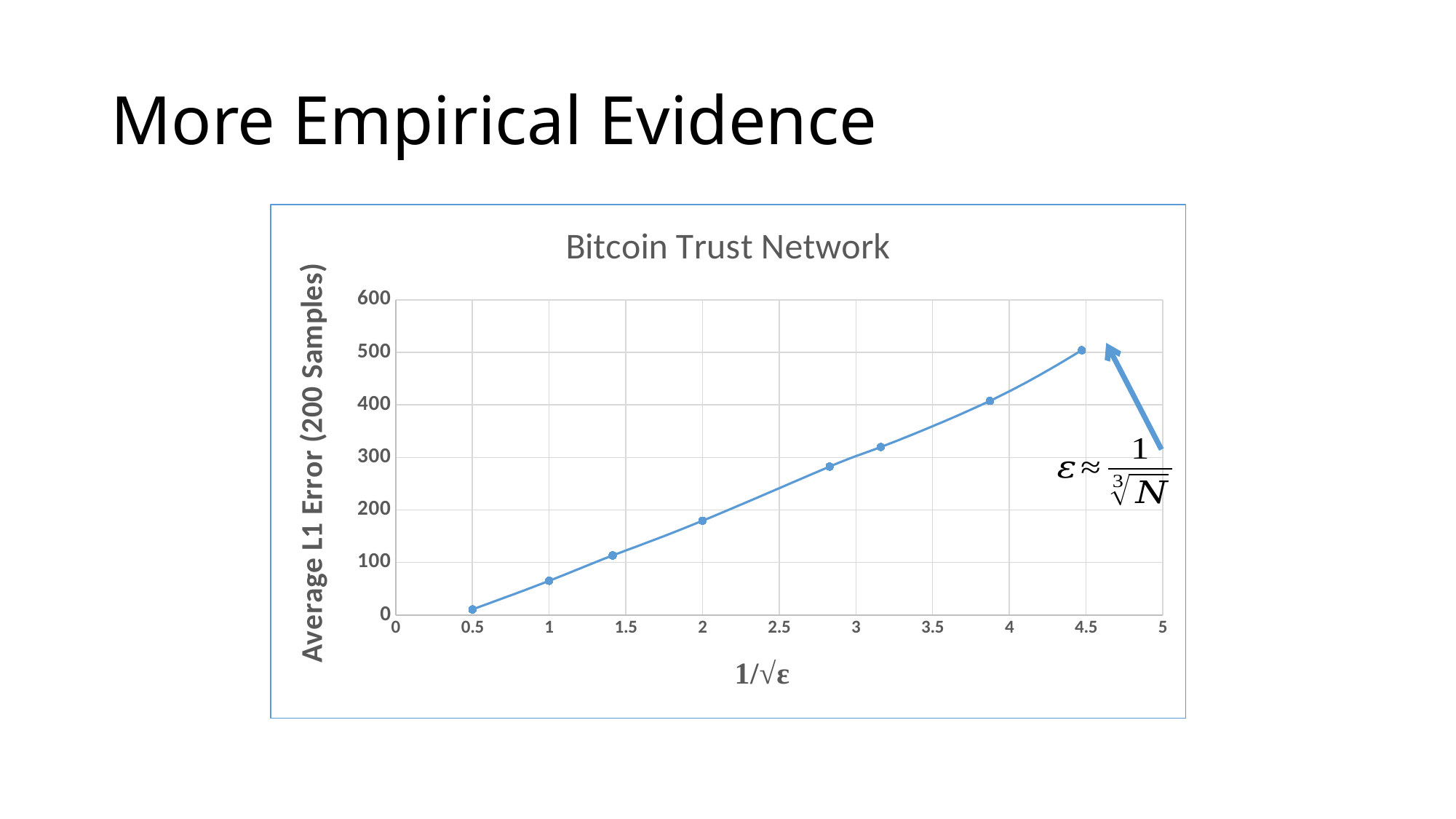
Is the value at 1/√ε = 2 greater or less than 100? greater Which is larger, the value at 1/√ε = 2 or the value at 1/√ε = 1? 1/√ε = 2 Is the value at 1/√ε = 0.5 greater or less than 100? less Is the value of the rightmost data point greater or less than 400? greater How many data points are plotted on the line? 8 Do the values rise or fall as 1/√ε increases along the x axis? rise What is the label of the vertical axis? Average L1 Error (200 Samples) At which x value does the lowest average L1 error occur? 0.5 What is the title of the chart? Bitcoin Trust Network What kind of chart is shown on the slide? line chart